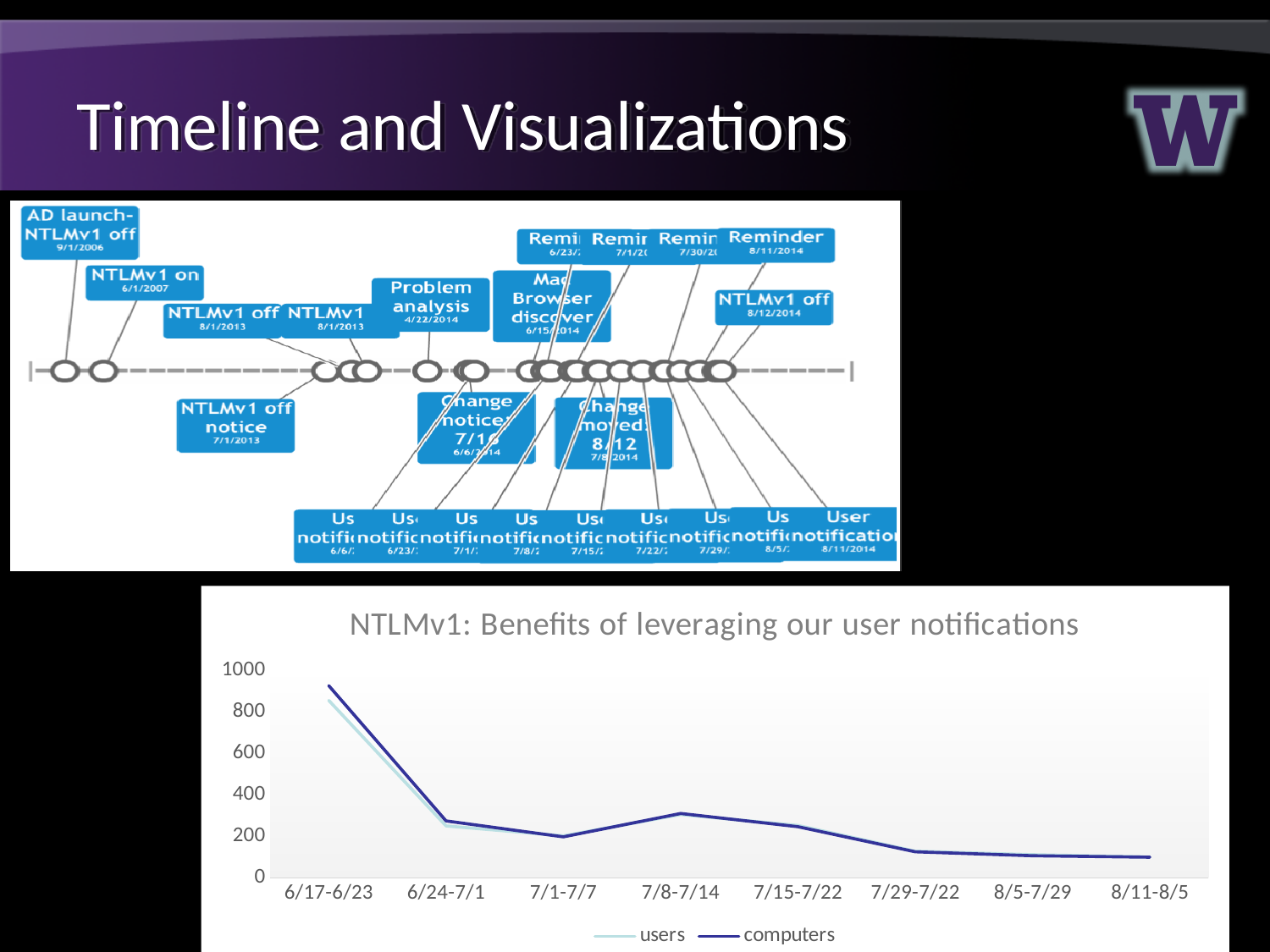
How many date-range categories are shown on the x axis of the line chart? 8 In the line chart, do the values for computers generally rise or fall from 6/17-6/23 to 8/11-8/5? fall What is the title of the line chart at the bottom of the slide? NTLMv1: Benefits of leveraging our user notifications How many series does the legend of the line chart list? 2 What kind of chart is the chart titled "NTLMv1: Benefits of leveraging our user notifications"? line chart In the line chart, which category has the highest value for computers? 6/17-6/23 What are the two series named in the legend of the line chart? users and computers In the line chart, which is larger for computers: the value at 6/17-6/23 or the value at 6/24-7/1? 6/17-6/23 In the line chart, is the value for computers at 6/17-6/23 greater or less than 800? greater In the line chart, which is larger for computers: the value at 7/1-7/7 or the value at 7/8-7/14? 7/8-7/14 In the line chart, is the value for computers at 7/29-7/22 greater or less than 200? less